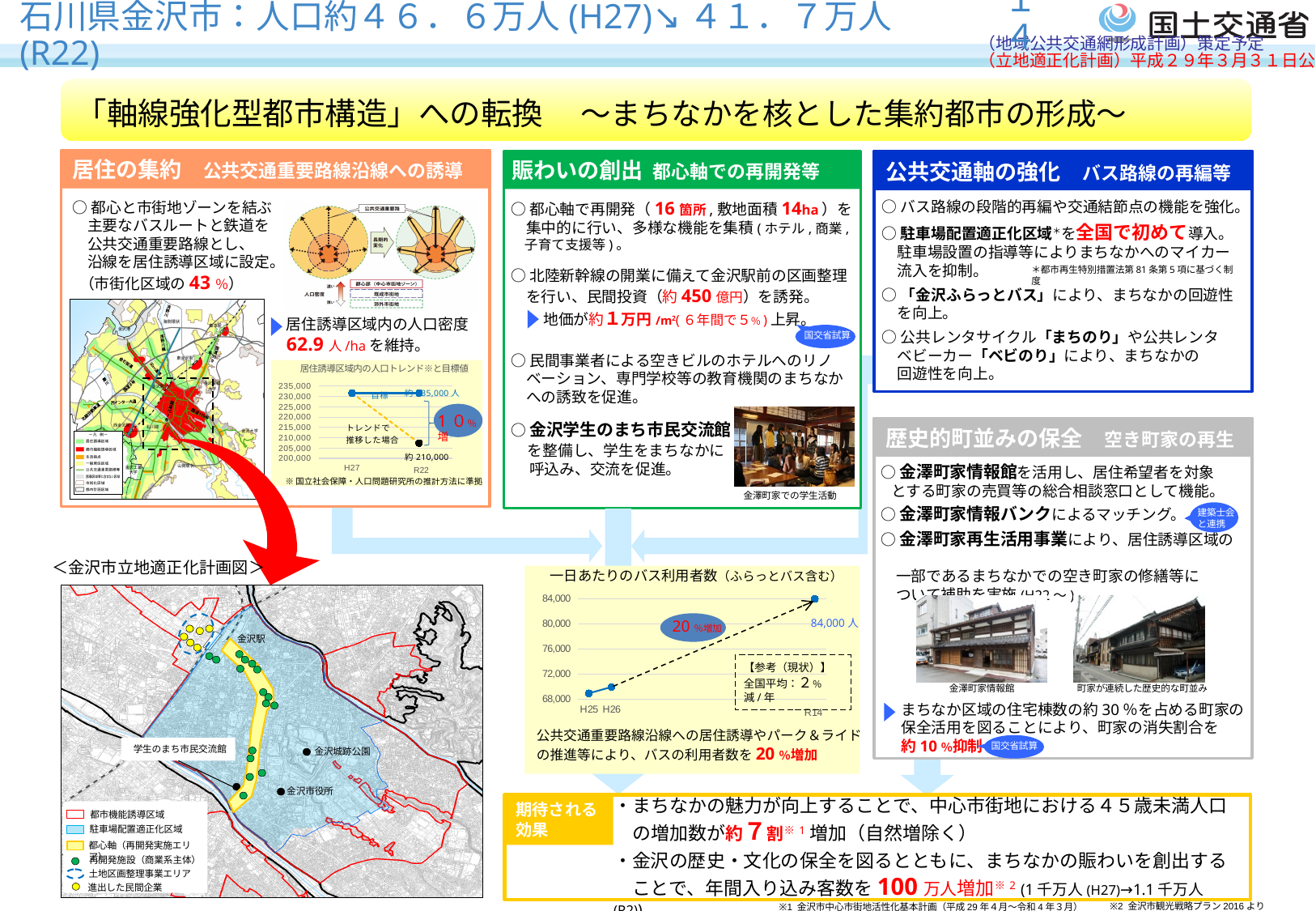
In the 「居住誘導区域内の人口トレンド※と目標値」 chart, what are the two x-axis labels? H27 and R22 In the 「一日あたりのバス利用者数（ふらっとバス含む）」 chart, what value is labelled at the R14 end of the line? 84,000人 In the 「居住誘導区域内の人口トレンド※と目標値」 chart, is the 目標 (target) value at R22 greater or less than 230,000? greater In the 「一日あたりのバス利用者数（ふらっとバス含む）」 chart, what percentage increase is labelled on the chart? 20%増 What kind of chart is the 「一日あたりのバス利用者数（ふらっとバス含む）」 chart? line chart In the 「居住誘導区域内の人口トレンド※と目標値」 chart, which line is higher at R22, 目標 or トレンドで推移した場合? 目標 What kind of chart is the 「居住誘導区域内の人口トレンド※と目標値」 chart? line chart In the 「居住誘導区域内の人口トレンド※と目標値」 chart, what percentage increase is labelled between the trend line and the target line? 10%増 In the 「一日あたりのバス利用者数（ふらっとバス含む）」 chart, do the bus ridership values rise or fall from H25 to R14? rise In the 「一日あたりのバス利用者数（ふらっとバス含む）」 chart, is the value for H25 greater or less than 72,000? less In the 「一日あたりのバス利用者数（ふらっとバス含む）」 chart, which is larger, the value for H25 or the value for R14? R14 In the 「居住誘導区域内の人口トレンド※と目標値」 chart, is the トレンドで推移した場合 value at R22 greater or less than 215,000? less